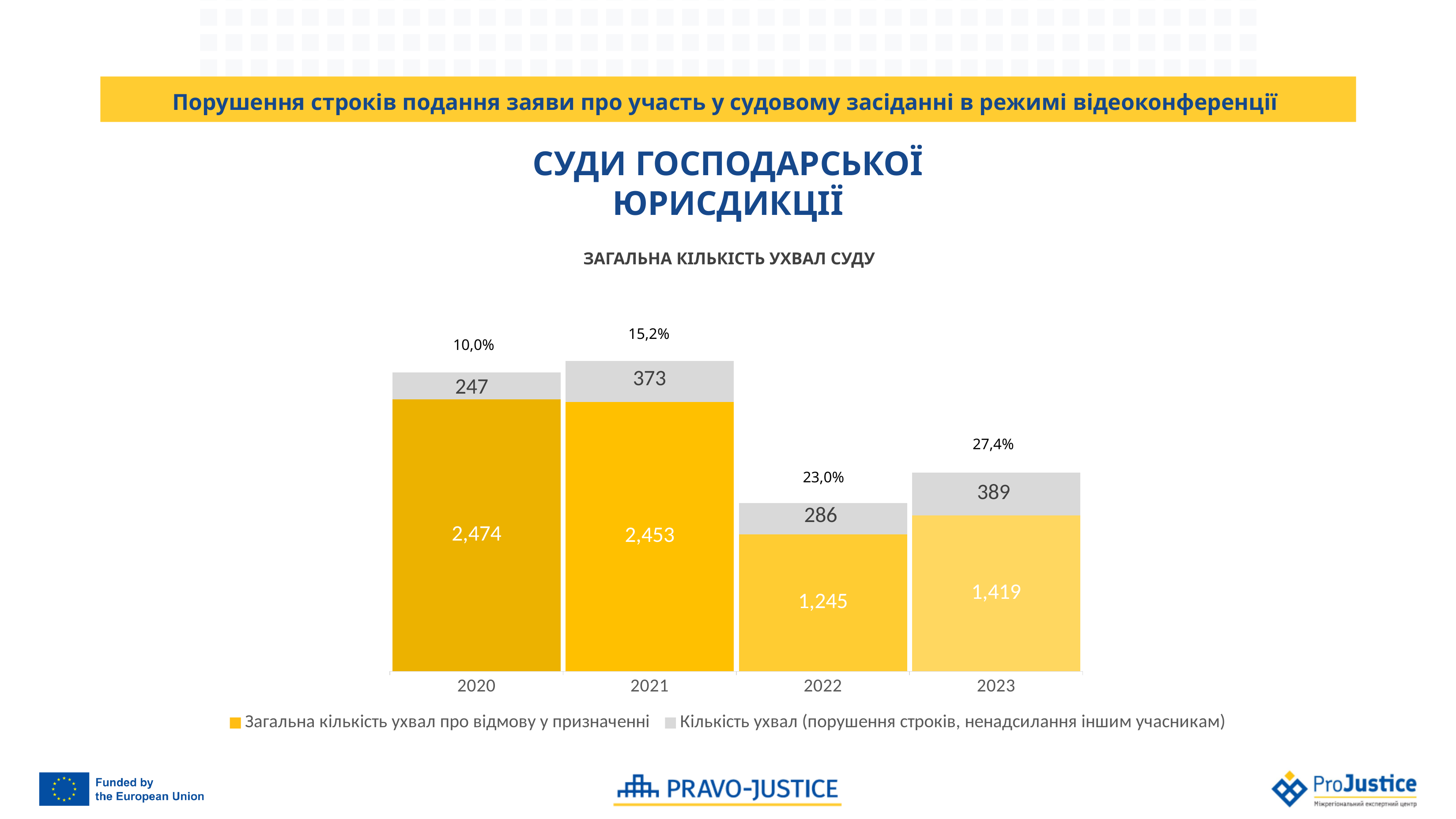
What is the total of the stacked bar for 2022? 1,531 How many years are shown on the x axis? 4 What is the value of the yellow series for 2022? 1,245 How many series does the legend list? 2 What percentage is shown above the bar for 2023? 27,4% In which year is the yellow series (Загальна кількість ухвал про відмову у призначенні) lowest? 2022 Do the percentages shown above the bars rise or fall from 2020 to 2023? rise In which year is the grey series (Кількість ухвал (порушення строків, ненадсилання іншим учасникам)) highest? 2023 Which is larger: the yellow series value for 2020 or for 2021? 2020 What is the value of the grey series (Кількість ухвал (порушення строків, ненадсилання іншим учасникам)) for 2021? 373 What is the value of the yellow series (Загальна кількість ухвал про відмову у призначенні) for 2020? 2,474 What is the difference between the grey series values for 2023 and 2020? 142